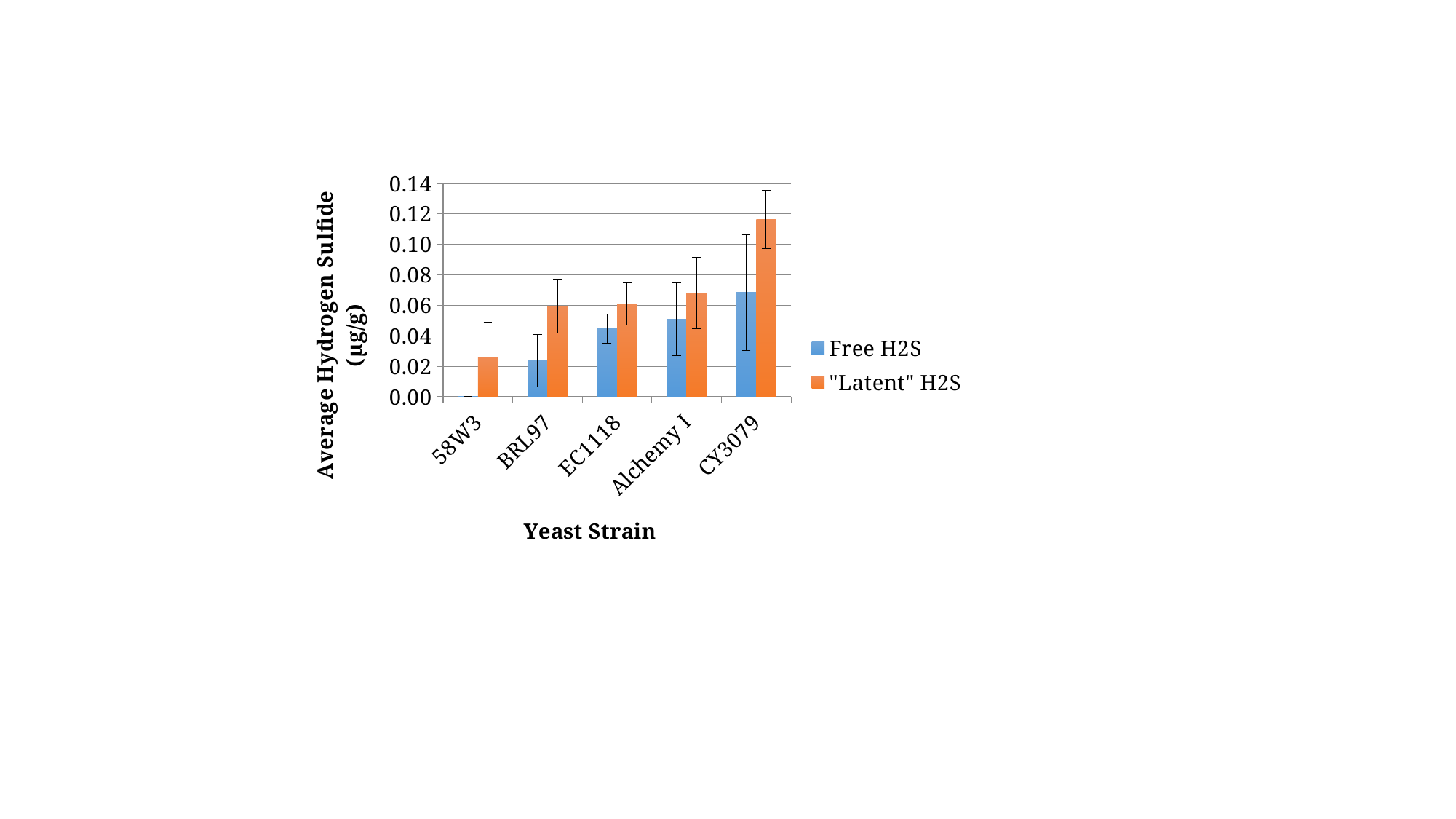
Which yeast strain has the lowest Free H2S value? 58W3 How many series does the legend list? 2 Is the "Latent" H2S value for CY3079 greater or less than 0.10? greater What kind of chart is shown on the slide? bar chart Which is larger, the Free H2S value for CY3079 or the Free H2S value for Alchemy I? CY3079 What is the title of the y axis? Average Hydrogen Sulfide (µg/g) Is the Free H2S value for BRL97 greater or less than 0.04? less Which yeast strain has the highest "Latent" H2S value? CY3079 Do the Free H2S values rise or fall moving from 58W3 to CY3079 along the x axis? rise How many yeast strains are shown on the x axis? 5 Is the "Latent" H2S value for 58W3 greater or less than 0.04? less